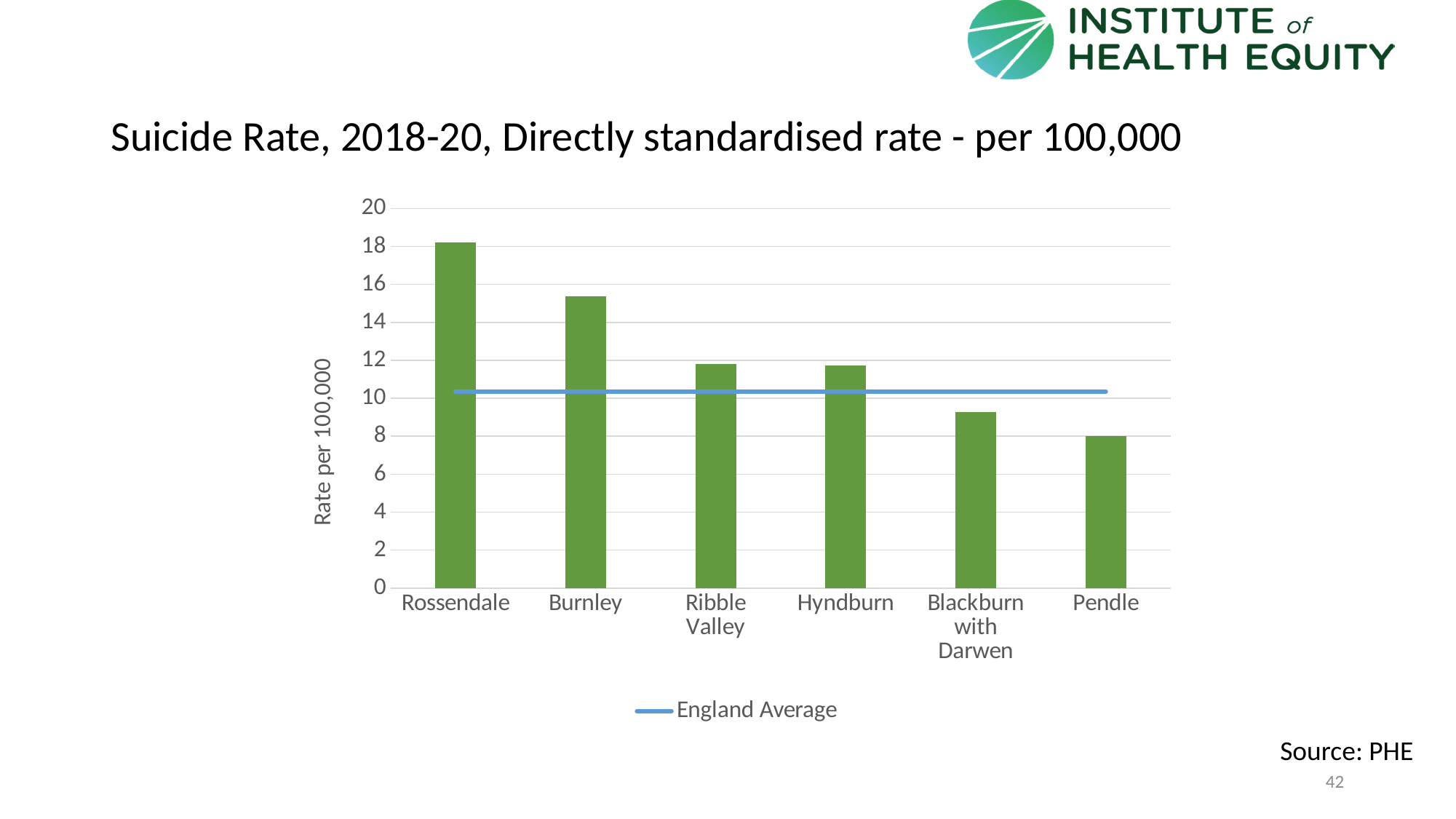
Is the value for Burnley greater or less than 14? greater Which area has the lowest suicide rate in the chart? Pendle Is the value for Hyndburn greater or less than 10? greater What kind of chart is shown on the slide? Bar chart Which has the higher suicide rate, Burnley or Ribble Valley? Burnley How many areas are shown on the x axis of the chart? 6 Is the value for Rossendale greater or less than 16? greater What does the blue horizontal line in the chart represent, according to the legend? England Average Which area has the highest suicide rate in the chart? Rossendale Do the bar values rise or fall from left to right across the chart? Fall